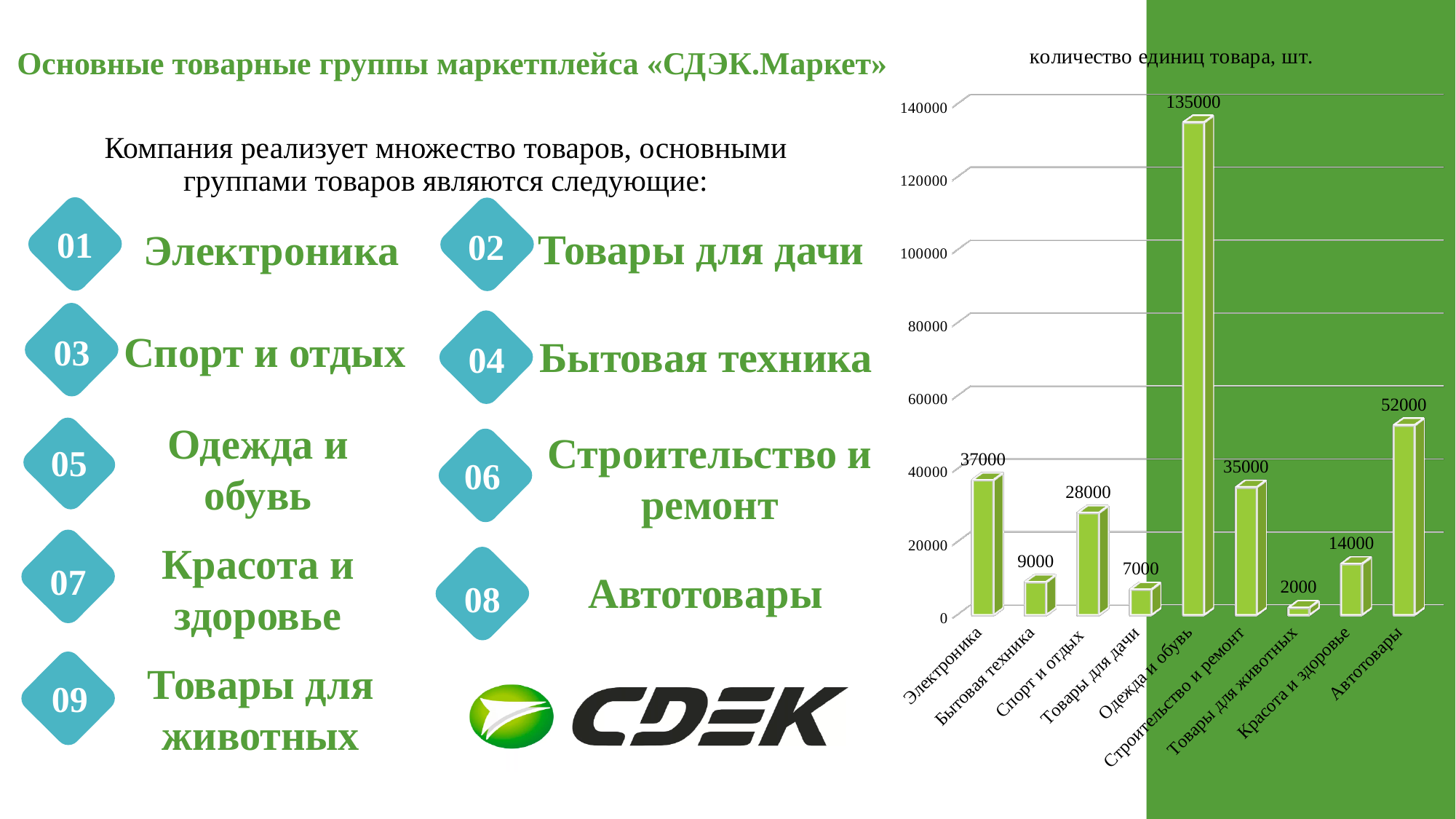
What is the title of the chart? количество единиц товара, шт. How many categories are shown on the x axis? 9 Is the value for Автотовары greater or less than 40000? greater What kind of chart is shown on the slide? bar chart What is the value for Электроника? 37000 What is the difference between the values for Автотовары and Строительство и ремонт? 17000 What is the value for Товары для животных? 2000 Which category has the lowest value? Товары для животных Which category has the highest value? Одежда и обувь What is the value for Красота и здоровье? 14000 Which is larger, the value for Спорт и отдых or the value for Бытовая техника? Спорт и отдых What is the value for Одежда и обувь? 135000